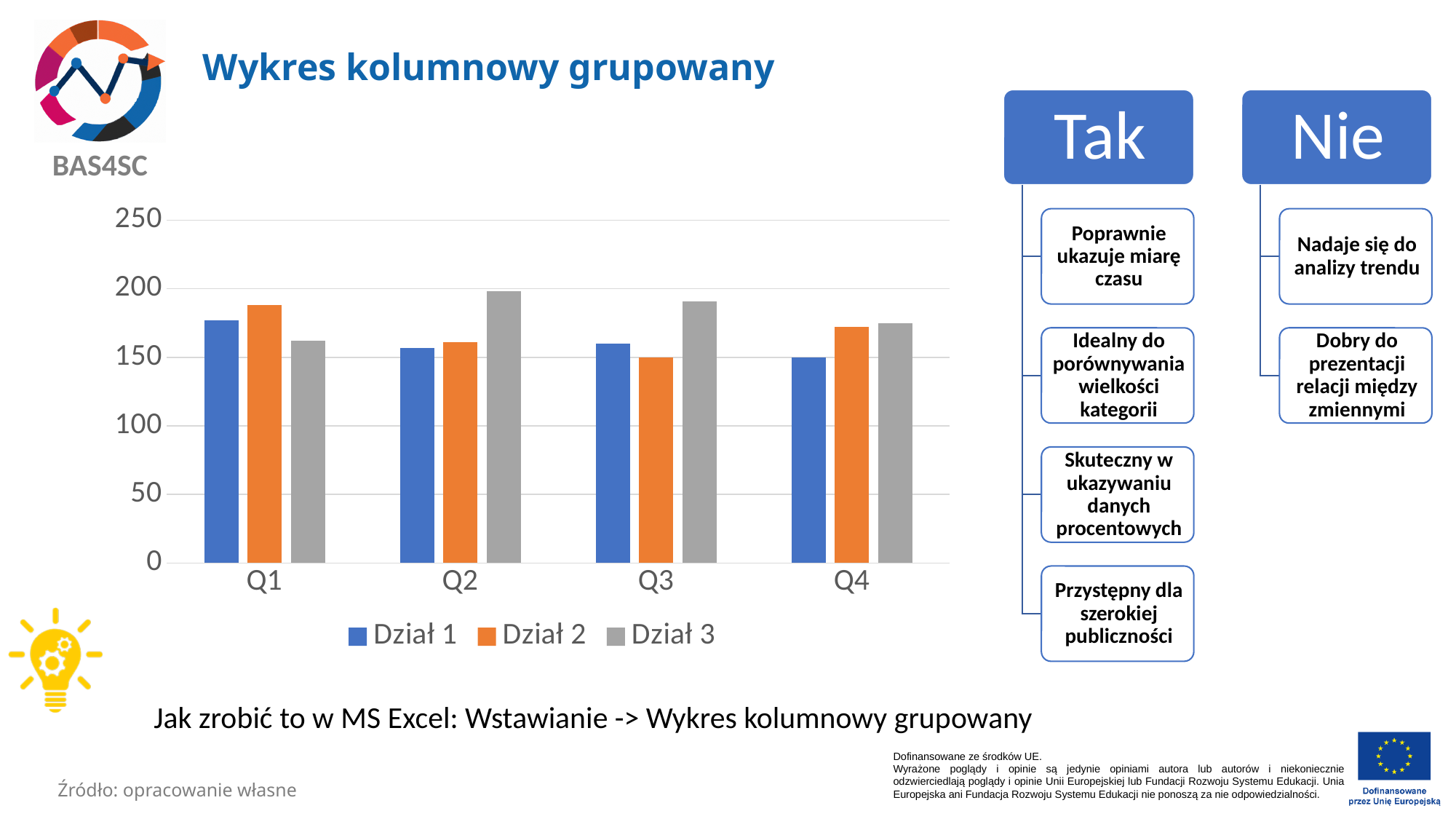
Is the value for Dział 1 in Q1 greater or less than 150? greater What are the names of the series in the chart legend? Dział 1, Dział 2, Dział 3 Is the value for Dział 3 in Q3 greater or less than 200? less How many series does the chart legend list? 3 In which quarter does Dział 2 have its highest value? Q1 How many categories are shown on the x axis of the chart? 4 In Q1, which is larger: Dział 2 or Dział 3? Dział 2 In Q4, which is larger: Dział 1 or Dział 2? Dział 2 What kind of chart is shown on the slide? bar chart Is the value for Dział 3 in Q2 greater or less than 150? greater In Q2, which is larger: Dział 1 or Dział 3? Dział 3 What is the title of the slide containing the chart? Wykres kolumnowy grupowany